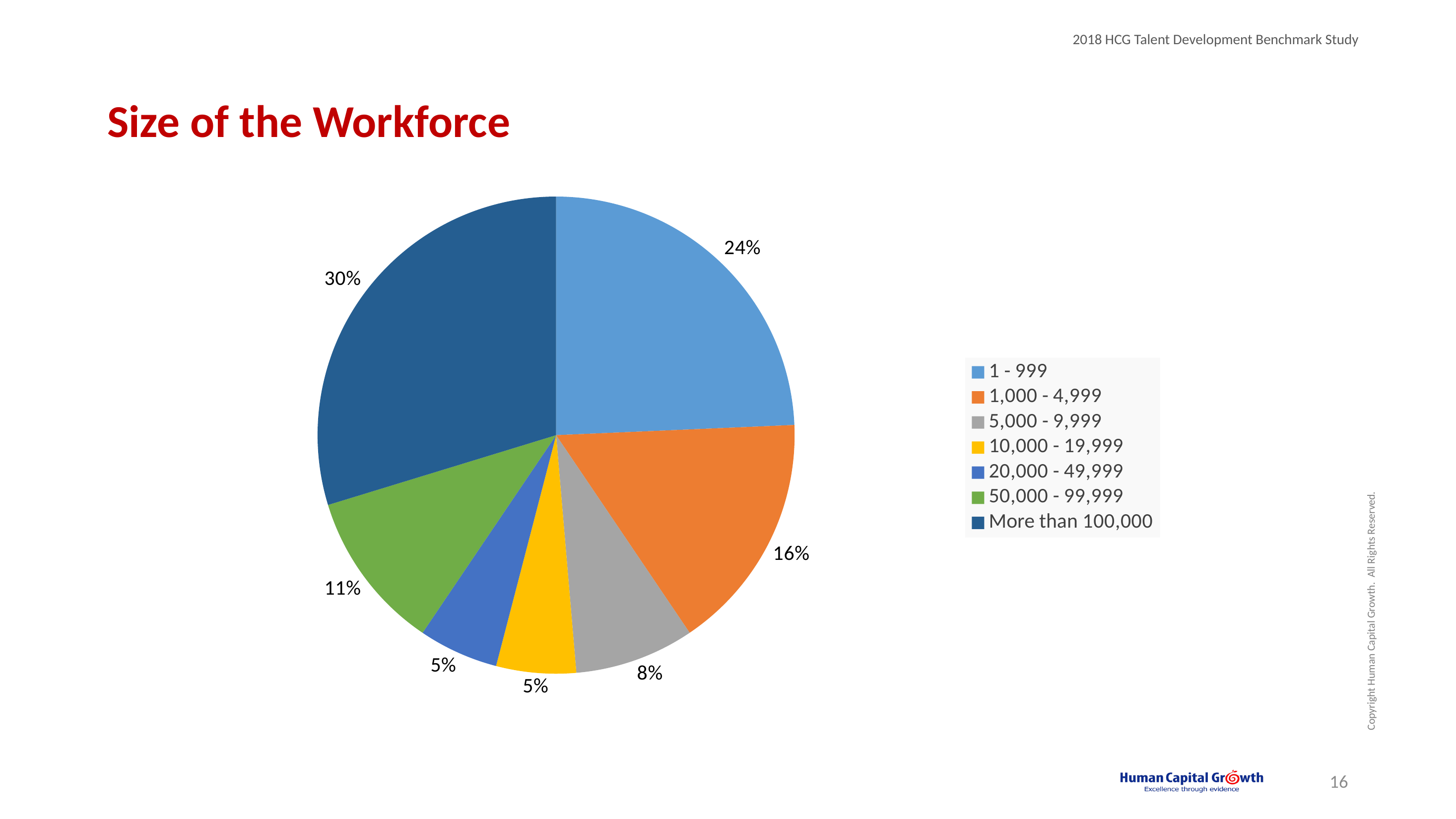
What colour is the '10,000 - 19,999' slice? Yellow What is the title of the slide containing the chart? Size of the Workforce What share of the pie does the 'More than 100,000' slice represent? 30% What kind of chart is shown on the slide? Pie chart Which is larger, the '50,000 - 99,999' slice or the '5,000 - 9,999' slice? 50,000 - 99,999 How many categories does the pie chart show? 7 What is the value shown for the '50,000 - 99,999' category? 11% What is the value shown for the '5,000 - 9,999' category? 8% What is the difference between the '1 - 999' slice and the '1,000 - 4,999' slice? 8% What is the value shown for the '1,000 - 4,999' category? 16% Which category has the largest slice of the pie? More than 100,000 What share of the pie does the '1 - 999' slice represent? 24%